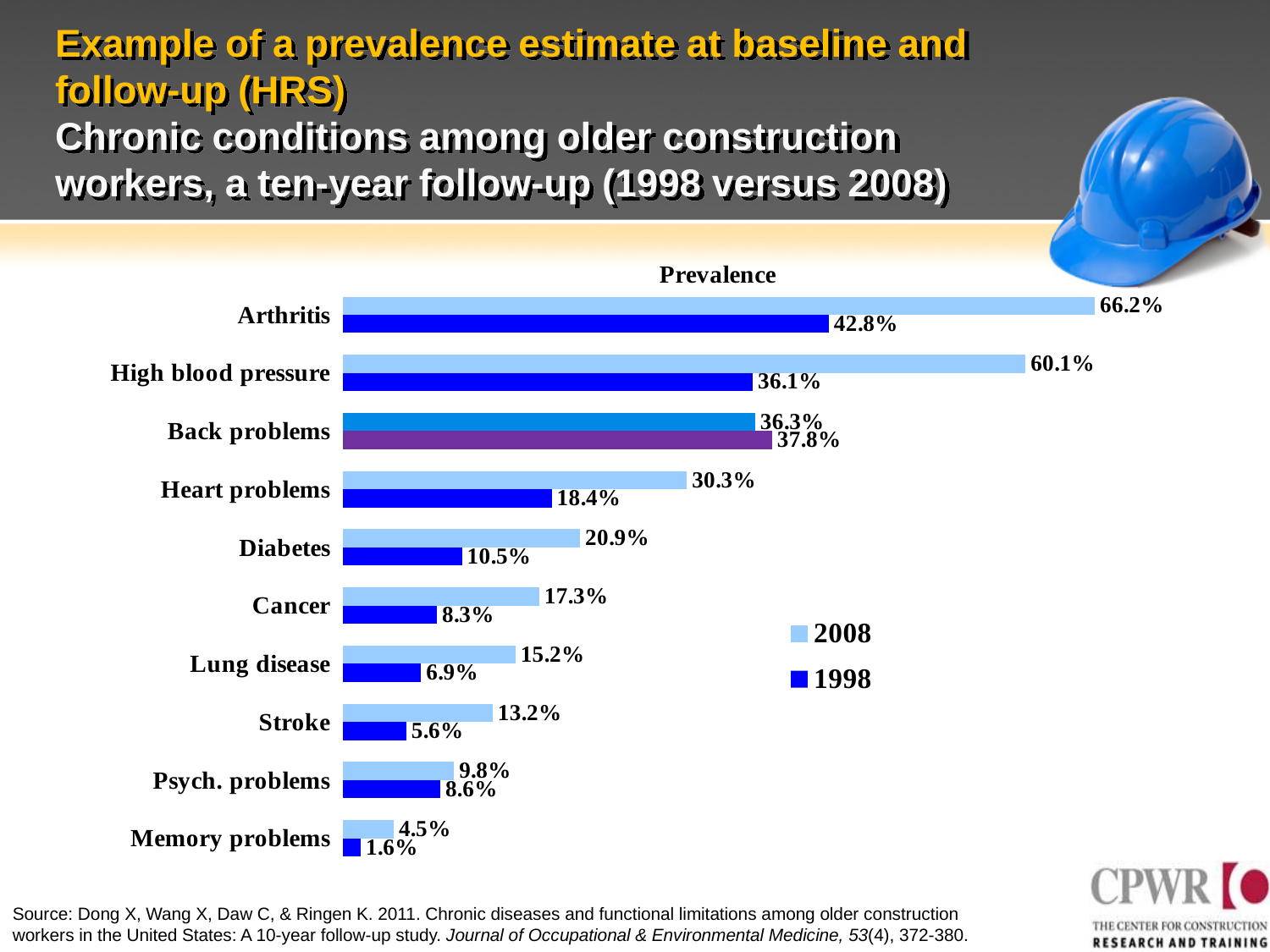
How many chronic conditions are listed on the chart? 10 Which condition has the highest 2008 prevalence? Arthritis What kind of chart is shown on the slide? Bar chart What is the 2008 prevalence of stroke? 13.2% What is the 1998 prevalence of diabetes? 10.5% How many series does the legend list? 2 What is the title of the chart? Prevalence Which condition has the lowest 1998 prevalence? Memory problems What is the difference between the 2008 and 1998 prevalence of heart problems? 11.9% Which is larger for back problems, the 2008 value or the 1998 value? 1998 What is the 2008 prevalence of arthritis? 66.2% What is the 1998 prevalence of high blood pressure? 36.1%